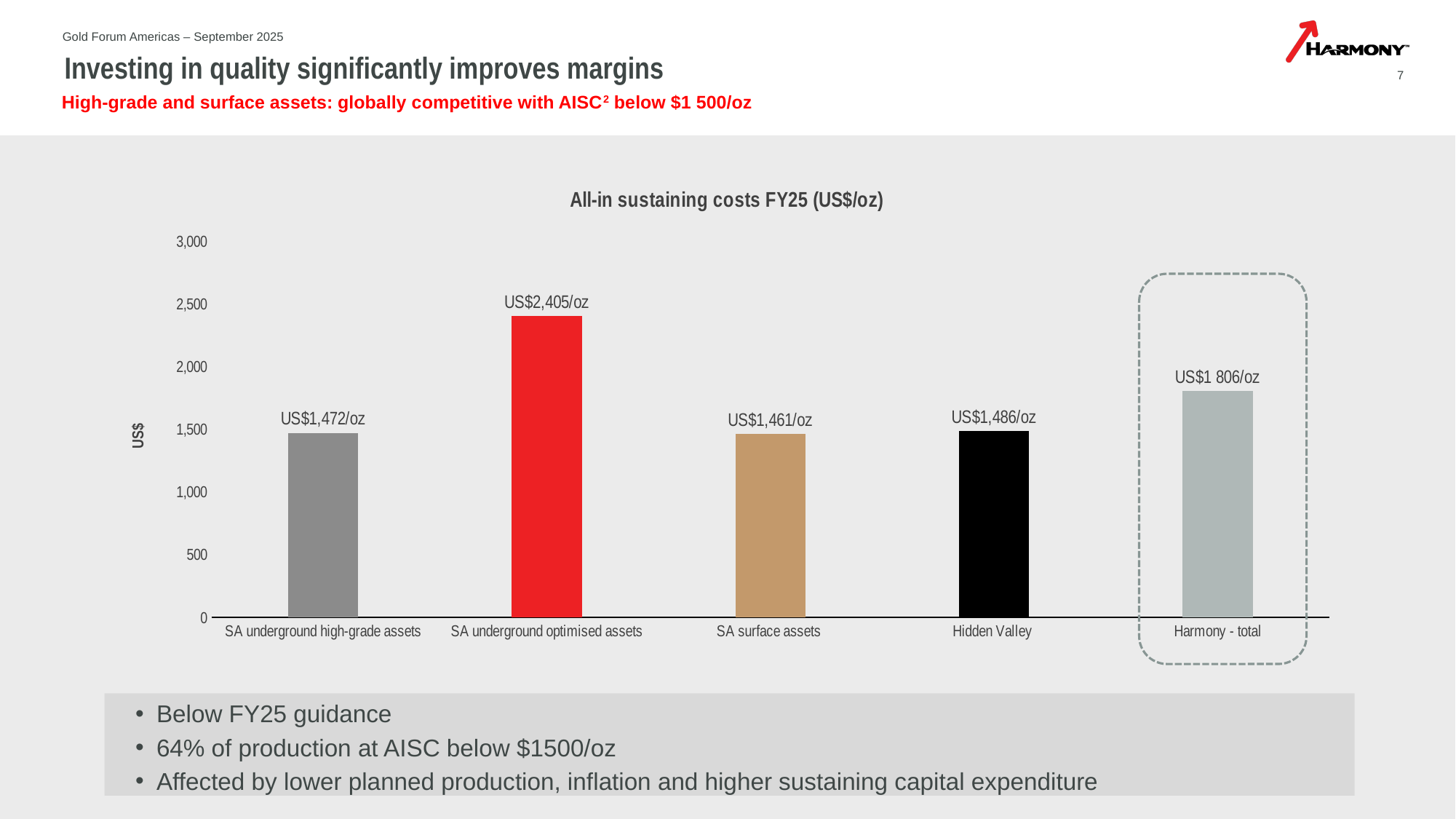
What is the title of the chart? All-in sustaining costs FY25 (US$/oz) What is the all-in sustaining cost for SA surface assets? US$1,461/oz What is the difference between the AISC of SA underground optimised assets and Harmony - total? US$599/oz Which category has the lowest all-in sustaining cost? SA surface assets What is the all-in sustaining cost for Harmony - total? US$1 806/oz What kind of chart is shown on the slide? Bar chart What is the all-in sustaining cost for Hidden Valley? US$1,486/oz What is the all-in sustaining cost for SA underground optimised assets? US$2,405/oz What is the all-in sustaining cost for SA underground high-grade assets? US$1,472/oz Which category has the highest all-in sustaining cost? SA underground optimised assets How many categories are shown on the x axis of the chart? 5 Which has a higher AISC, Hidden Valley or SA underground high-grade assets? Hidden Valley